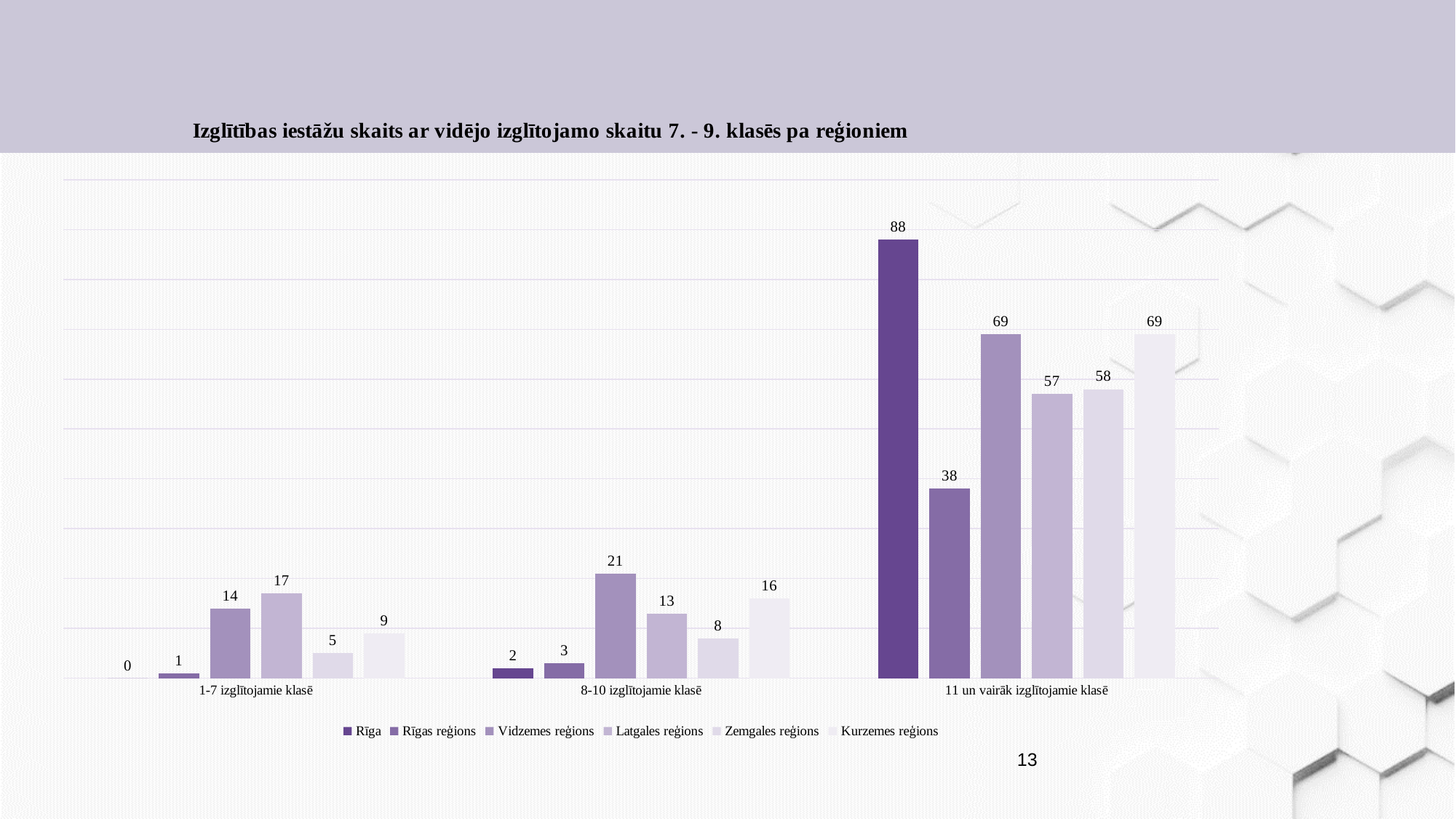
What is the value for Zemgales reģions in the '11 un vairāk izglītojamie klasē' category? 58 What is the value for Rīga in the '11 un vairāk izglītojamie klasē' category? 88 What is the value for Latgales reģions in the '1-7 izglītojamie klasē' category? 17 Which region has the highest value in the '1-7 izglītojamie klasē' category? Latgales reģions How many series does the legend list? 6 In the '8-10 izglītojamie klasē' category, which is larger: the value for Kurzemes reģions or the value for Latgales reģions? Kurzemes reģions What is the value for Vidzemes reģions in the '8-10 izglītojamie klasē' category? 21 What is the difference between the Rīga value and the Rīgas reģions value in the '11 un vairāk izglītojamie klasē' category? 50 How many categories are shown on the x axis? 3 Which region has the lowest value in the '11 un vairāk izglītojamie klasē' category? Rīgas reģions What is the title of the chart? Izglītības iestāžu skaits ar vidējo izglītojamo skaitu 7. - 9. klasēs pa reģioniem What kind of chart is shown on the slide? Bar chart